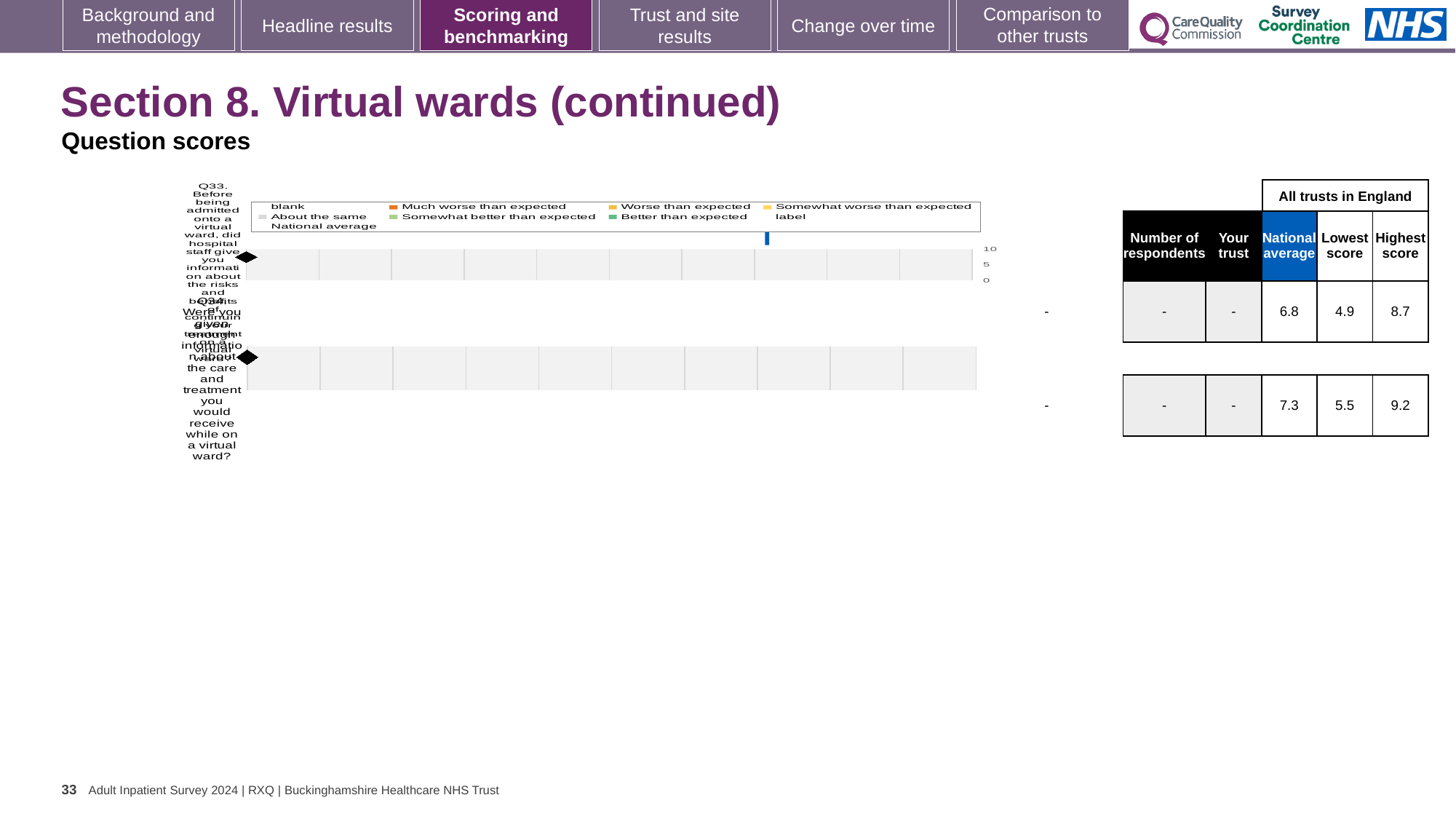
What is the national average score for Q33 shown in the table next to the chart? 6.8 What colour is used in the legend for 'Much worse than expected'? orange How many entries does the chart's legend list? 9 Which question has the higher national average, Q33 or Q34? Q34 What is shown as the 'Your trust' score for Q33? - What is the difference between the highest score and the lowest score for Q34? 3.7 What is the difference between the highest score and the lowest score for Q33? 3.8 What is the lowest score among all trusts in England for Q33? 4.9 How many questions (categories) are plotted on the chart? 2 What is the highest value shown on the chart's x axis? 10 What kind of chart is shown on the slide? bar chart What is the highest score among all trusts in England for Q34? 9.2